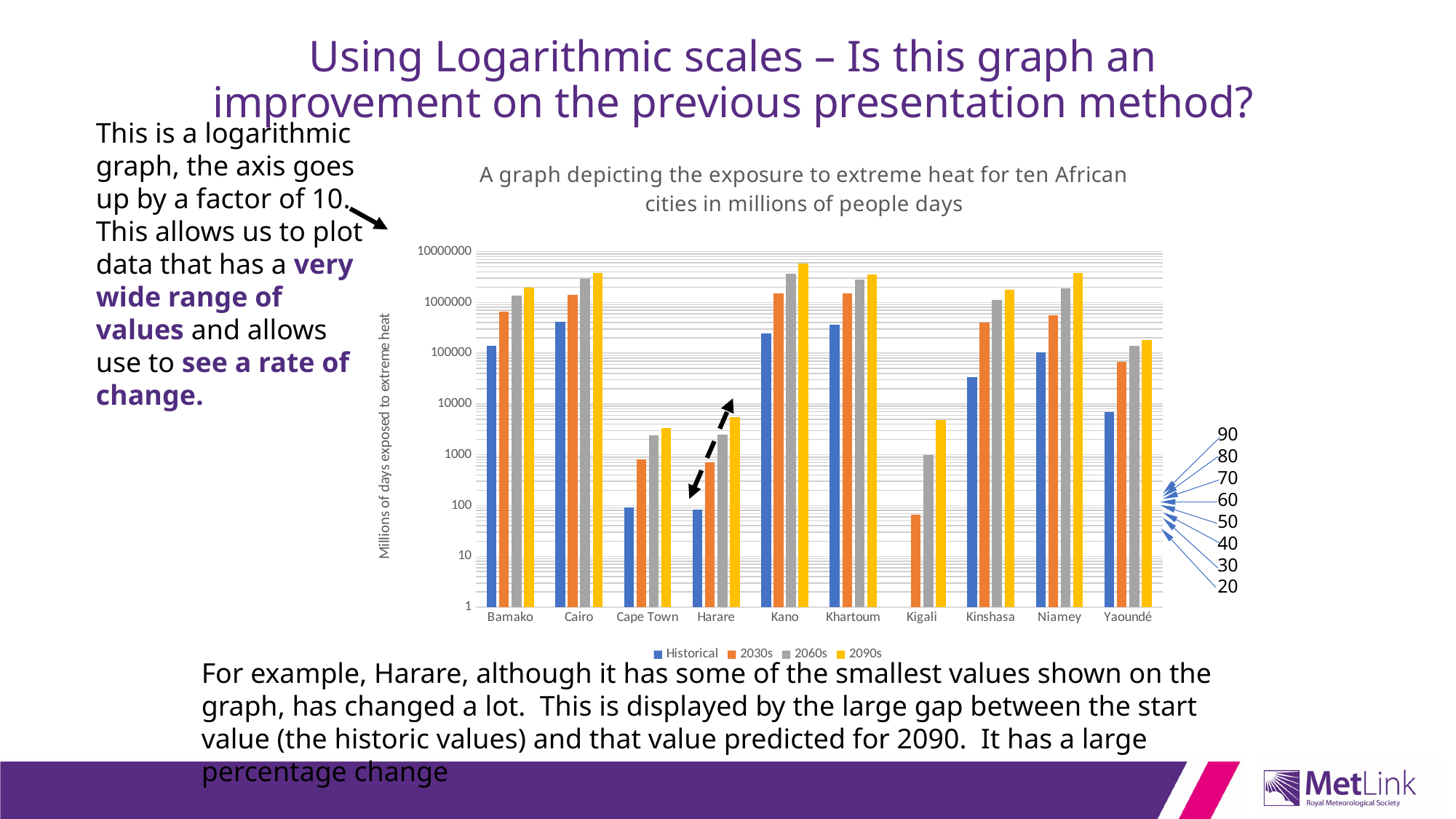
Is the Historical value for Kinshasa greater or less than 100000? less What kind of chart is shown on the slide? Bar chart Which city has the lowest 2030s value in the chart? Kigali What is the label on the vertical axis of the chart? Millions of days exposed to extreme heat How many cities are shown on the x axis of the chart? 10 For Harare, do the values rise or fall from Historical through to 2090s? rise Is the 2090s value for Kano greater or less than 1000000? greater Which city has the highest 2090s value in the chart? Kano Is the 2030s value for Kigali greater or less than 100? less Which is larger, the Historical value for Cairo or the Historical value for Bamako? Cairo How many series does the chart legend list? 4